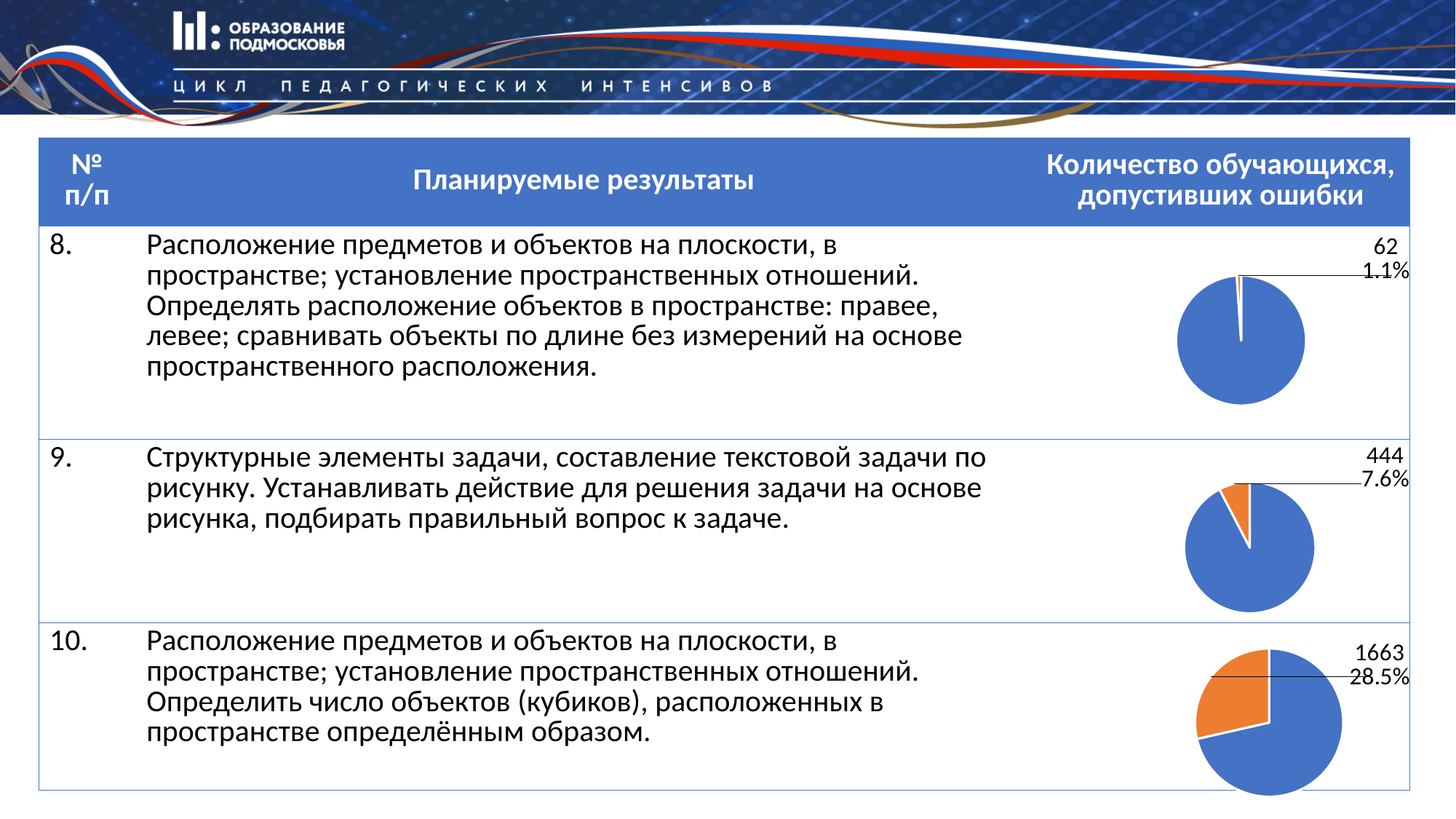
Which is larger: the labelled value in the pie chart for row 9 or the labelled value in the pie chart for row 10? row 10 In the pie chart for row 10, what share of the pie does the orange slice represent? 28.5% Which row's pie chart has the smallest orange slice: row 8, row 9 or row 10? row 8 In the pie chart for row 9, what share of the pie does the orange slice represent? 7.6% In the pie chart for row 9, what number of students is shown on the orange slice's data label? 444 In the pie chart for row 8, what number of students is shown on the orange slice's data label? 62 What is the difference between the labelled values in the pie charts for row 10 and row 9? 1219 In the pie chart for row 10, what number of students is shown on the orange slice's data label? 1663 In the pie chart for row 8, what percentage is shown on the orange slice's data label? 1.1% Which row's pie chart has the largest orange slice: row 8, row 9 or row 10? row 10 How many pie charts are shown on the slide? 3 What kind of chart is shown in row 8 of the table? pie chart